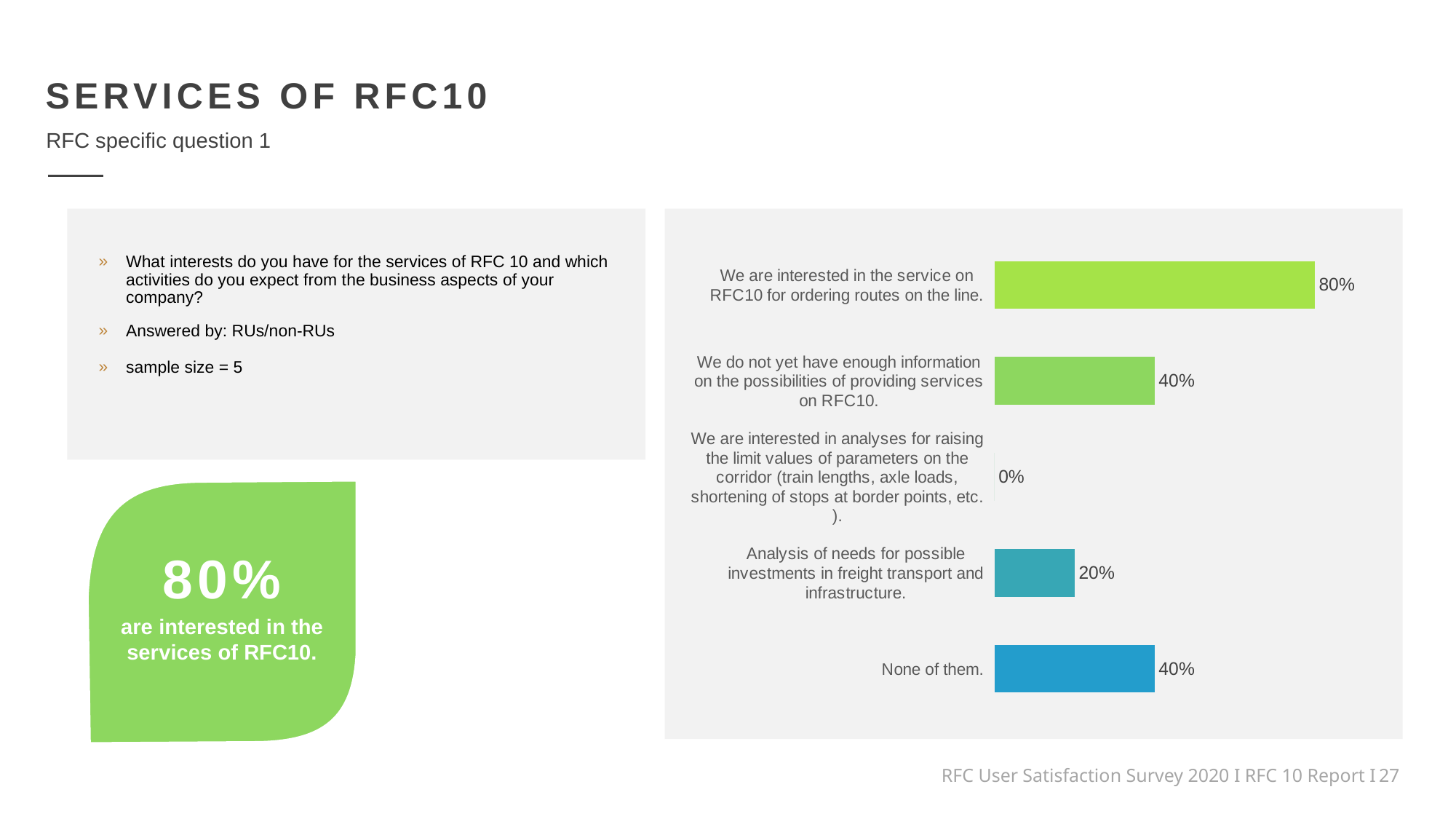
What kind of chart is shown on the slide? Bar chart What percentage is shown for "We do not yet have enough information on the possibilities of providing services on RFC10."? 40% What percentage is shown for the category about analyses for raising the limit values of parameters on the corridor? 0% What percentage is shown for "We are interested in the service on RFC10 for ordering routes on the line."? 80% Which is larger: the value for "None of them." or the value for "Analysis of needs for possible investments in freight transport and infrastructure."? None of them. What percentage is shown for "Analysis of needs for possible investments in freight transport and infrastructure."? 20% What is the sample size stated on the slide for this question? 5 What percentage is shown for "None of them."? 40% Which category has the highest value in the chart? We are interested in the service on RFC10 for ordering routes on the line. How many categories are shown in the chart? 5 What is the difference between the value for "We are interested in the service on RFC10 for ordering routes on the line." and the value for "None of them."? 40% Which category has the lowest value in the chart? We are interested in analyses for raising the limit values of parameters on the corridor (train lengths, axle loads, shortening of stops at border points, etc.).